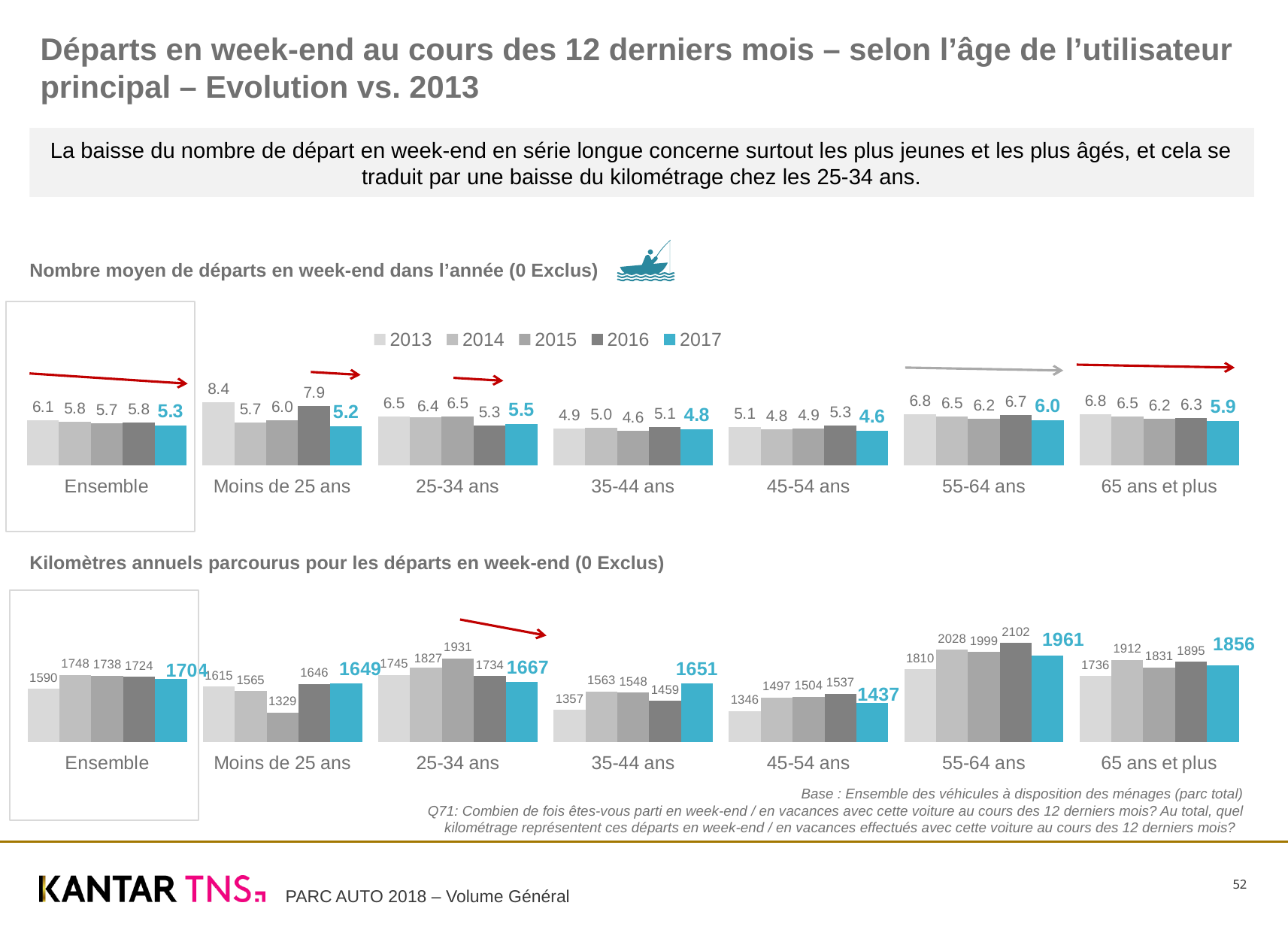
In the top chart (Nombre moyen de départs en week-end dans l'année), how many series does the legend list? 5 In the top chart (Nombre moyen de départs en week-end dans l'année), what is the difference between the 2013 and 2017 values for Moins de 25 ans? 3.2 In the bottom chart (Kilomètres annuels parcourus pour les départs en week-end), is the 2017 value for 25-34 ans larger or smaller than the 2017 value for 35-44 ans? larger In the bottom chart (Kilomètres annuels parcourus pour les départs en week-end), how many age categories are shown, including Ensemble? 7 In the top chart (Nombre moyen de départs en week-end dans l'année), which age group has the lowest 2017 value? 45-54 ans In the top chart (Nombre moyen de départs en week-end dans l'année), which age group has the highest 2017 value? 55-64 ans In the bottom chart (Kilomètres annuels parcourus pour les départs en week-end), what is the 2015 value for Moins de 25 ans? 1329 What kind of chart is the top chart (Nombre moyen de départs en week-end dans l'année)? bar chart In the top chart (Nombre moyen de départs en week-end dans l'année), what is the 2017 value for Moins de 25 ans? 5.2 In the bottom chart (Kilomètres annuels parcourus pour les départs en week-end), which age group has the lowest 2017 value? 45-54 ans In the top chart (Nombre moyen de départs en week-end dans l'année), what is the 2013 value for 55-64 ans? 6.8 In the bottom chart (Kilomètres annuels parcourus pour les départs en week-end), what is the 2017 value for 55-64 ans? 1961